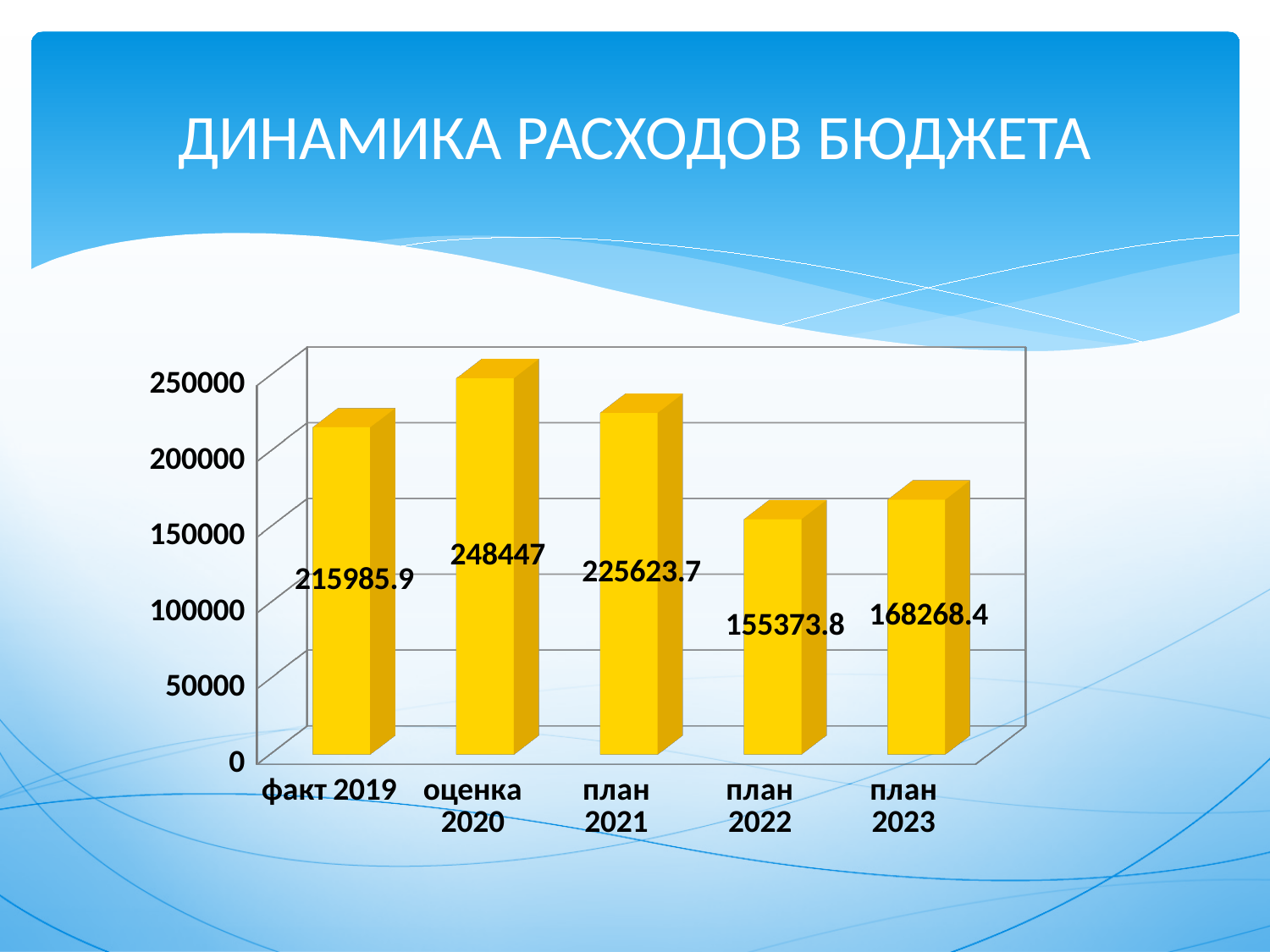
What is the value for план 2023? 168268.4 What is the difference between the values for оценка 2020 and факт 2019? 32461.1 Which is larger, the value for план 2021 or the value for факт 2019? план 2021 What is the value for факт 2019? 215985.9 What is the value for оценка 2020? 248447 What is the title of the chart? ДИНАМИКА РАСХОДОВ БЮДЖЕТА Which category has the highest value? оценка 2020 How many categories are shown on the x axis? 5 What is the value for план 2022? 155373.8 Is the value for план 2022 greater or less than 200000? less What is the difference between the values for план 2023 and план 2022? 12894.6 Which category has the lowest value? план 2022